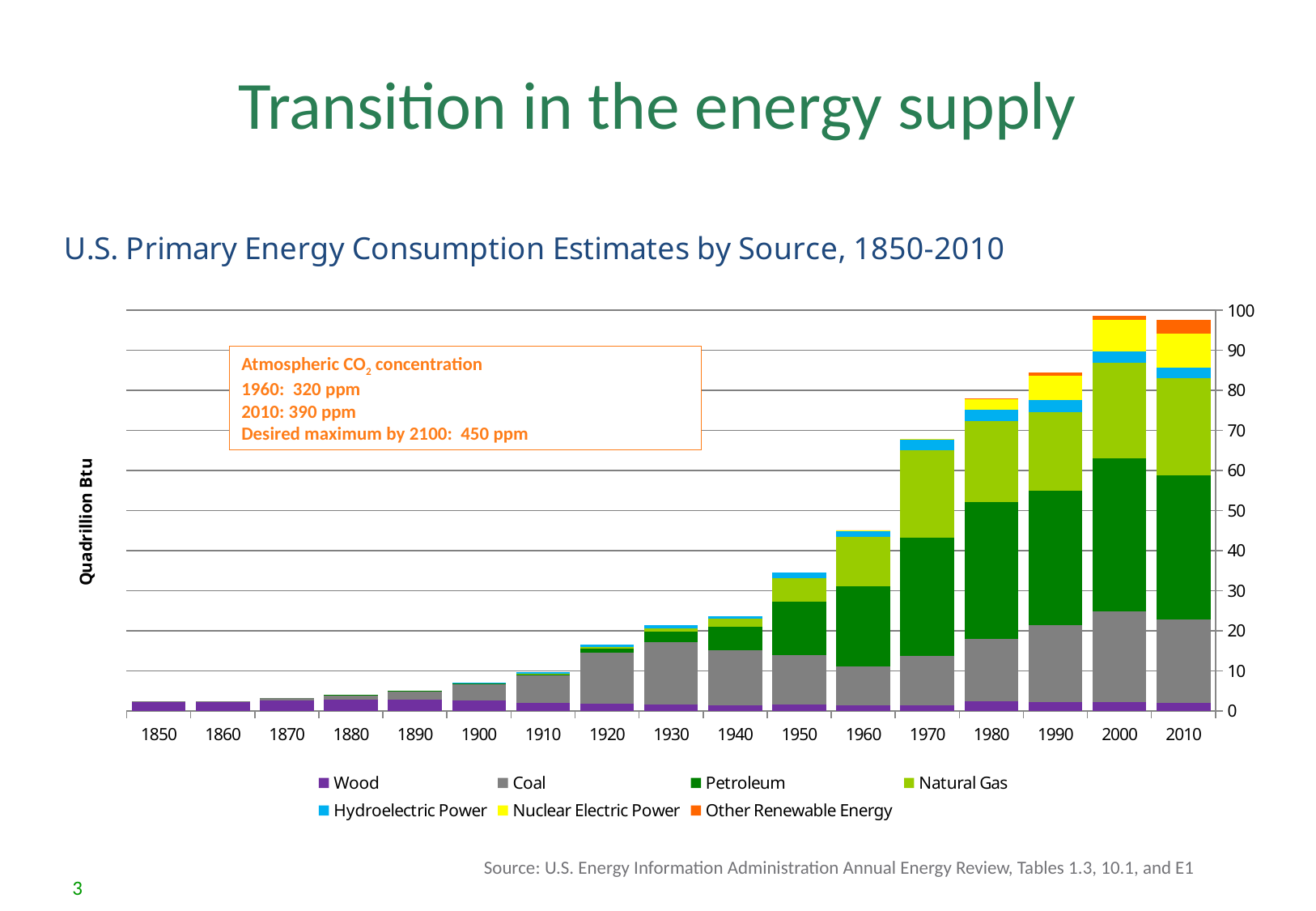
What is the label on the y axis of the chart? Quadrillion Btu What kind of chart is shown on the slide? Stacked bar chart Which year has the larger total energy consumption, 1950 or 1970? 1970 Is the total energy consumption for 2000 greater or less than 90 quadrillion Btu? greater Does total U.S. primary energy consumption generally rise or fall from 1850 to 2010? Rise Which energy source is shown in dark green in the legend? Petroleum Is the total energy consumption for 1950 greater or less than 40 quadrillion Btu? less How many years (bars) are plotted along the x axis? 17 Is the total energy consumption for 1900 greater or less than 10 quadrillion Btu? less How many energy sources does the legend list? 7